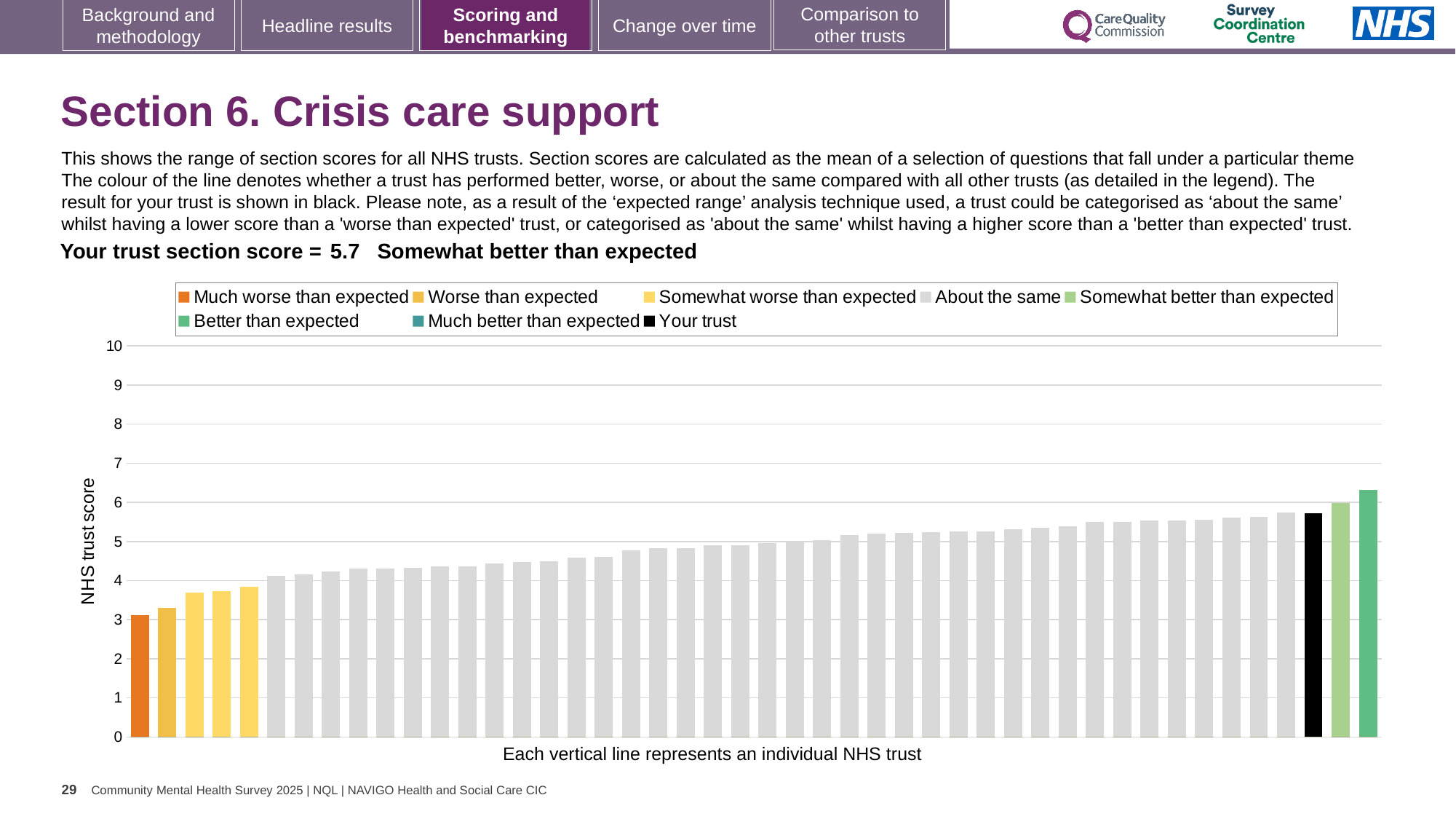
Which is higher, the black 'Your trust' bar or the rightmost green bar? the rightmost green bar What is the highest value shown on the vertical axis? 10 What is the label on the vertical axis of the chart? NHS trust score What kind of chart is shown on the slide? bar chart Is the value of the rightmost bar greater or less than 6? greater What is the section score for your trust? 5.7 How many bars are coloured orange (Much worse than expected)? 1 Is the value of the leftmost (orange) bar greater or less than 4? less Which category is your trust's section score placed in? Somewhat better than expected Do the bar values rise or fall from left to right along the x axis? rise How many entries does the chart legend list? 8 Is the value of the black 'Your trust' bar greater or less than 5? greater